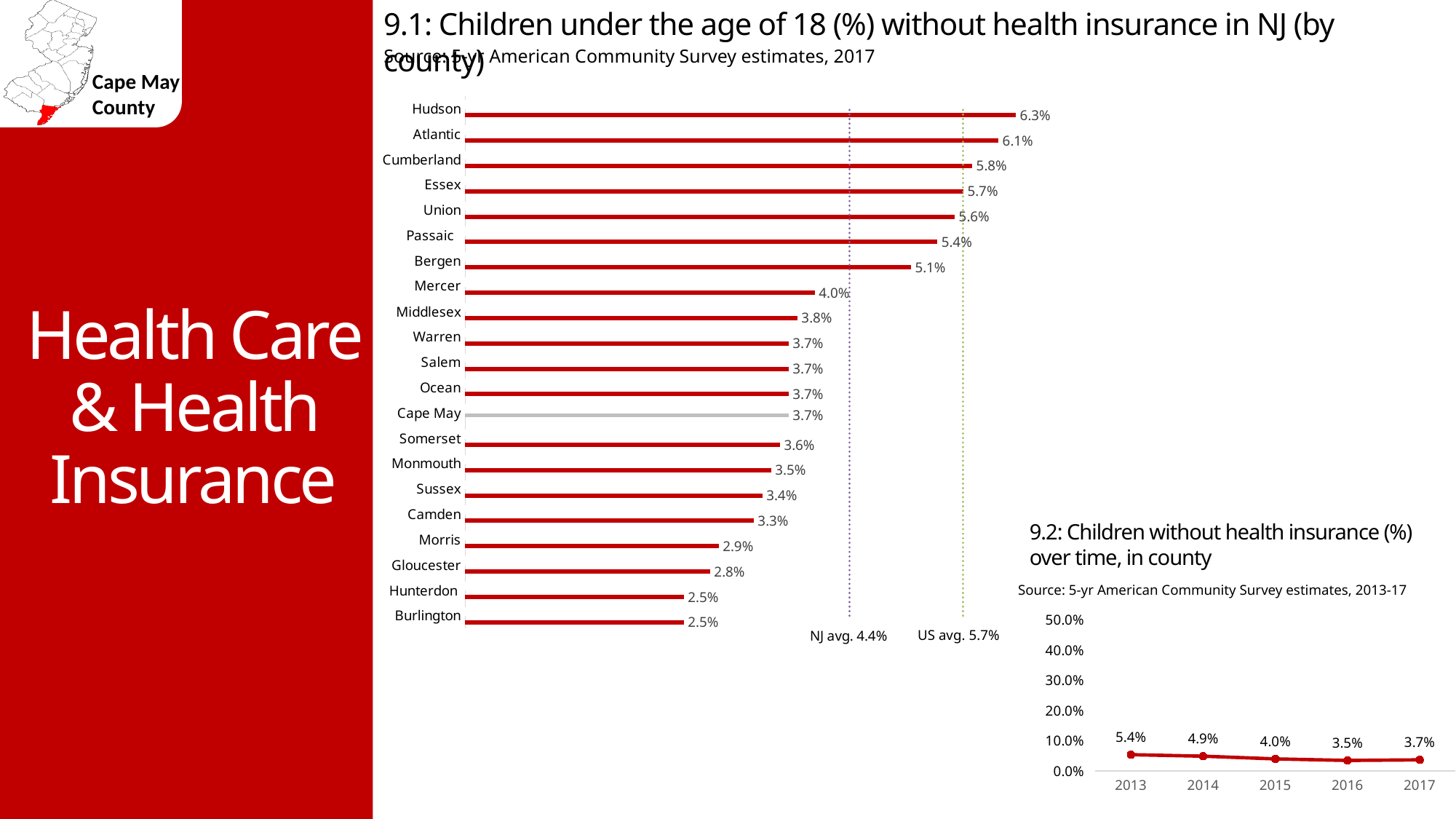
In chart 9.1, what is the NJ average shown by the dotted reference line? 4.4% In chart 9.1, what is the value for Bergen? 5.1% What kind of chart is chart 9.2? Line chart In chart 9.1, what is the difference between Hudson and Burlington? 3.8% In chart 9.2, what is the difference between the 2013 and 2017 values? 1.7% In chart 9.1, how many counties are plotted? 21 In chart 9.1, which county has the highest percentage of children without health insurance? Hudson In chart 9.1, which is larger, the value for Passaic or the value for Mercer? Passaic In chart 9.2 (children without health insurance over time), what is the value for 2013? 5.4% In chart 9.1 (children under 18 without health insurance by county), what is the value for Cape May? 3.7% What kind of chart is chart 9.1? Bar chart In chart 9.2, which year has the lowest value? 2016